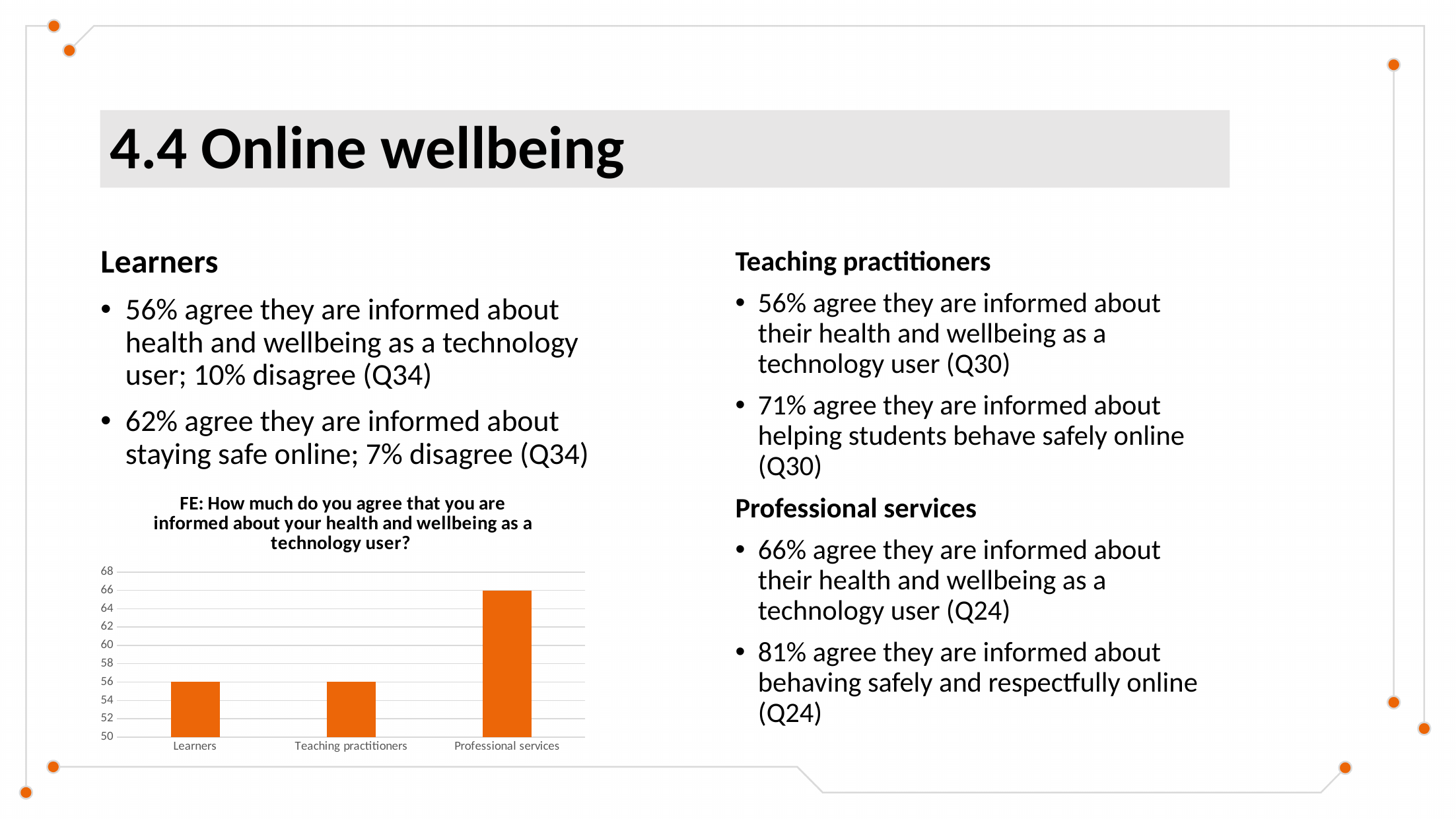
What is the value for Professional services in the chart? 66 Which is larger, the value for Professional services or the value for Teaching practitioners? Professional services Is the value for Learners greater or less than 60? less What is the highest value shown on the chart's vertical axis? 68 What is the difference between the values for Professional services and Learners? 10 What is the value for Teaching practitioners in the chart? 56 How many categories are shown in the chart? 3 Is the value for Professional services greater or less than 60? greater Which category has the highest value in the chart? Professional services What kind of chart is shown on the slide? bar chart What is the title of the chart? FE: How much do you agree that you are informed about your health and wellbeing as a technology user? What is the value for Learners in the chart? 56